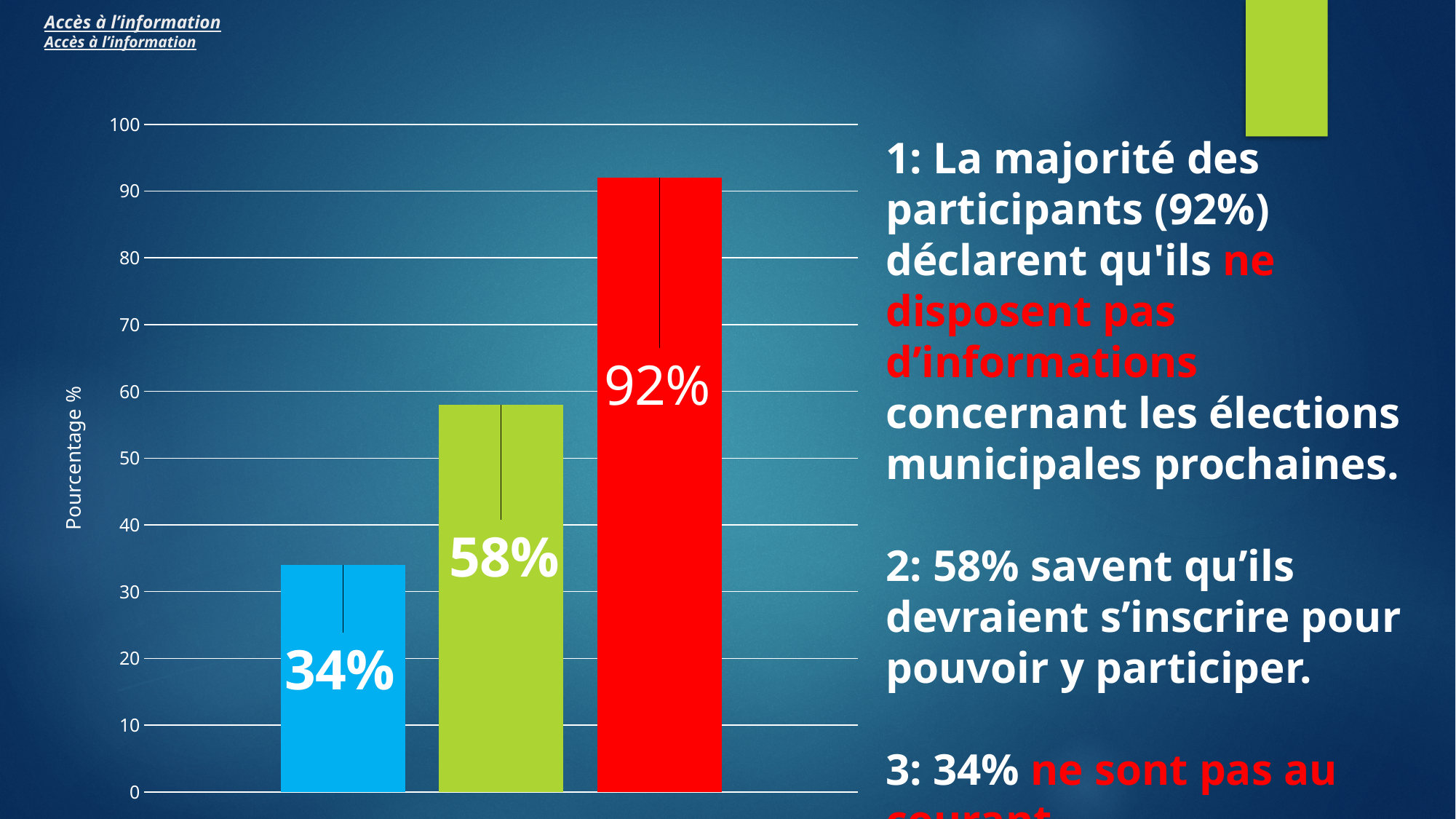
Which bar has the highest value? The red bar (92%) What is the difference between the green bar and the blue bar? 24% What is the label of the vertical axis? Pourcentage % What is the value shown on the green bar? 58% Which is larger, the green bar or the blue bar? The green bar Which bar has the lowest value? The blue bar (34%) What kind of chart is shown on the slide? Bar chart How many bars are plotted in the chart? 3 What is the value shown on the blue bar? 34% What is the value shown on the red bar? 92% What is the difference between the red bar and the blue bar? 58% Is the value of the red bar greater or less than 90? greater